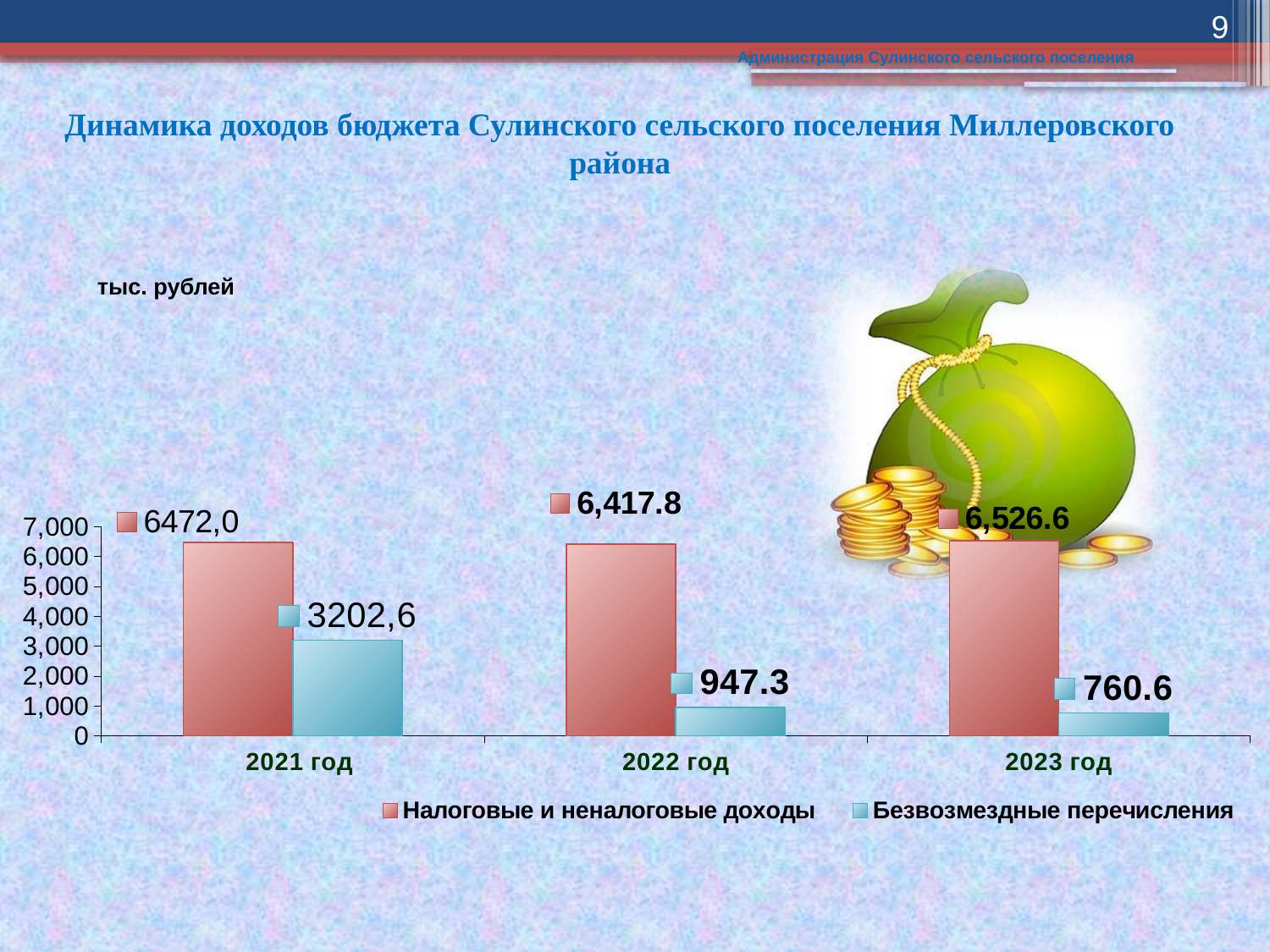
How many series does the legend list? 2 What is the difference between Безвозмездные перечисления in 2022 год and 2023 год? 186.7 Do the values for Безвозмездные перечисления rise or fall from 2021 год to 2023 год? fall What is the value of Безвозмездные перечисления for 2022 год? 947.3 Which is larger in 2021 год: Налоговые и неналоговые доходы or Безвозмездные перечисления? Налоговые и неналоговые доходы What is the difference between Налоговые и неналоговые доходы and Безвозмездные перечисления in 2022 год? 5,470.5 In which year is Безвозмездные перечисления the highest? 2021 год What is the value of Налоговые и неналоговые доходы for 2023 год? 6,526.6 What kind of chart is shown on the slide? bar chart What is the value of Налоговые и неналоговые доходы for 2021 год? 6472,0 What is the value of Безвозмездные перечисления for 2023 год? 760.6 In which year is Безвозмездные перечисления the lowest? 2023 год